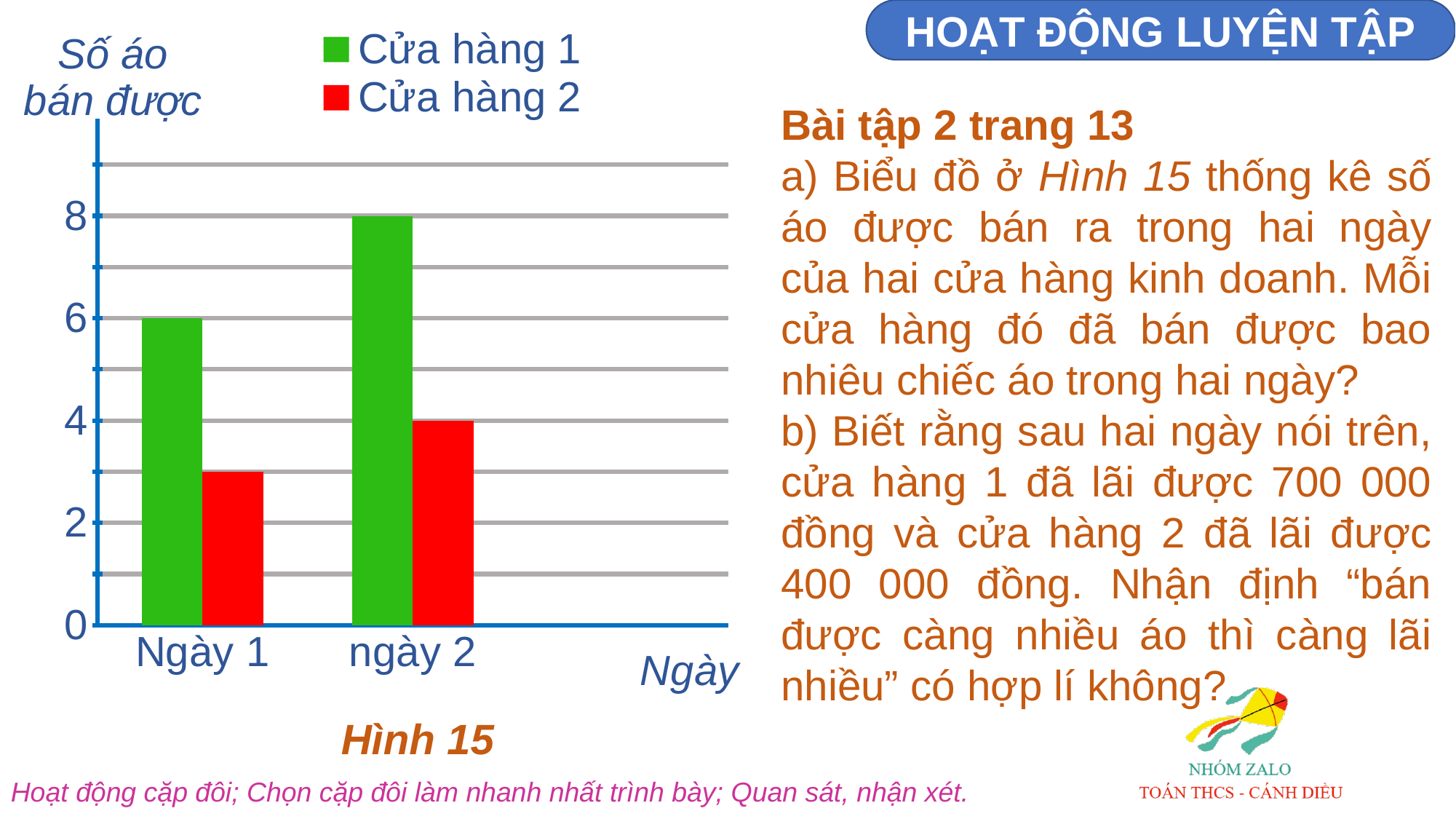
What is the difference between Cửa hàng 1 and Cửa hàng 2 on ngày 2? 4 Which bar is the shortest in the chart? Cửa hàng 2 on Ngày 1 What kind of chart is shown on the slide? bar chart How many series does the legend list? 2 What is the value for Cửa hàng 1 on Ngày 1? 6 What is the value for Cửa hàng 2 on ngày 2? 4 Which bar is the tallest in the chart? Cửa hàng 1 on ngày 2 What is the value for Cửa hàng 1 on ngày 2? 8 On Ngày 1, which sold more shirts, Cửa hàng 1 or Cửa hàng 2? Cửa hàng 1 How many days (categories) are shown on the x axis? 2 What is the difference between the values for Cửa hàng 1 on ngày 2 and on Ngày 1? 2 Is the value for Cửa hàng 2 on Ngày 1 greater or less than 2? greater